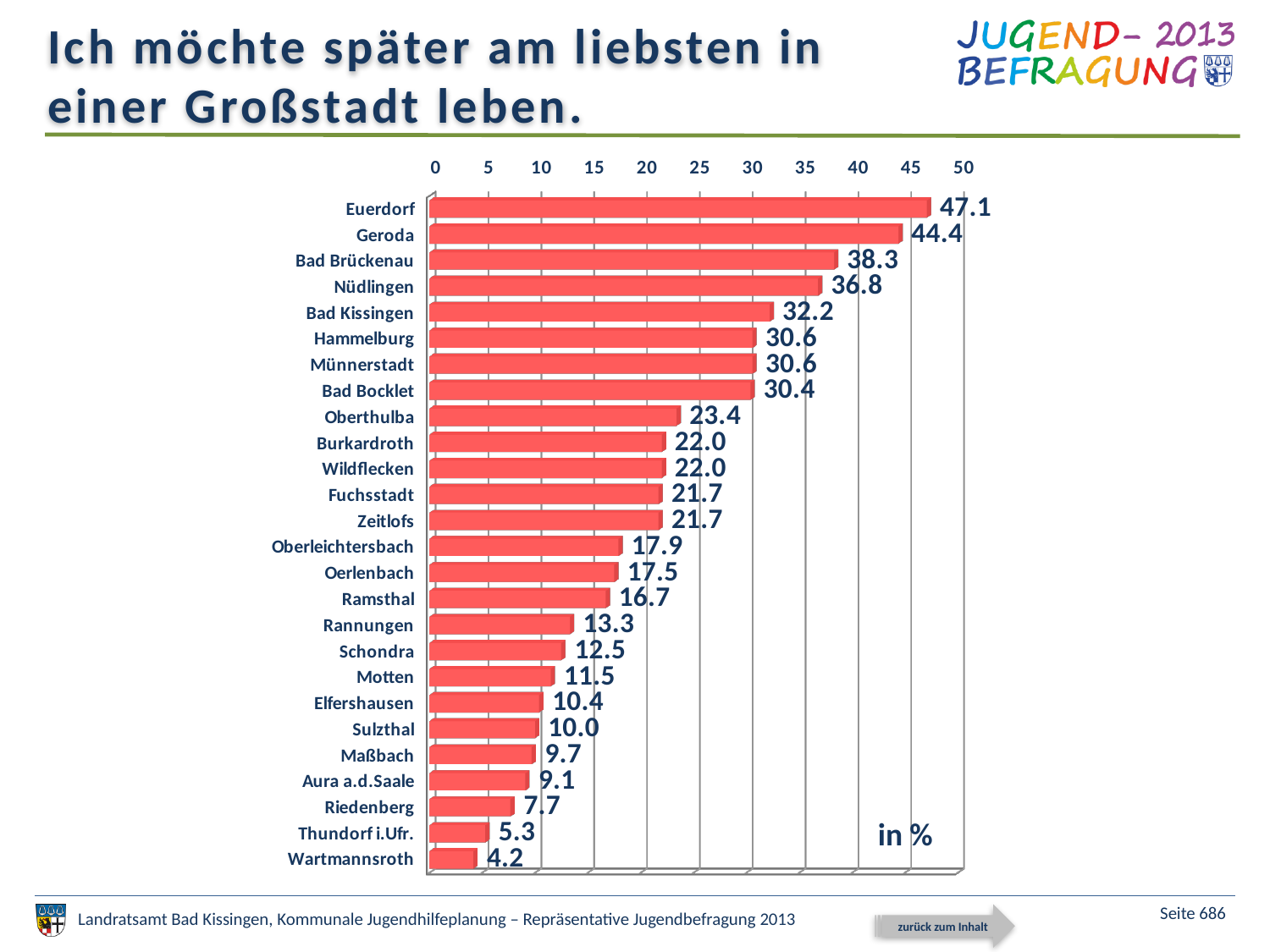
What is the value for Bad Kissingen? 32.2 What is the difference between the values for Bad Brückenau and Wartmannsroth? 34.1 What unit is indicated for the values in the chart? in % What kind of chart is shown on the slide? Bar chart What is the difference between the values for Euerdorf and Geroda? 2.7 Which municipality has the lowest value? Wartmannsroth What is the value for Euerdorf? 47.1 Which has a larger value, Nüdlingen or Hammelburg? Nüdlingen What is the value for Oberthulba? 23.4 How many municipalities are shown in the chart? 26 What is the value for Sulzthal? 10.0 Which municipality has the highest value? Euerdorf